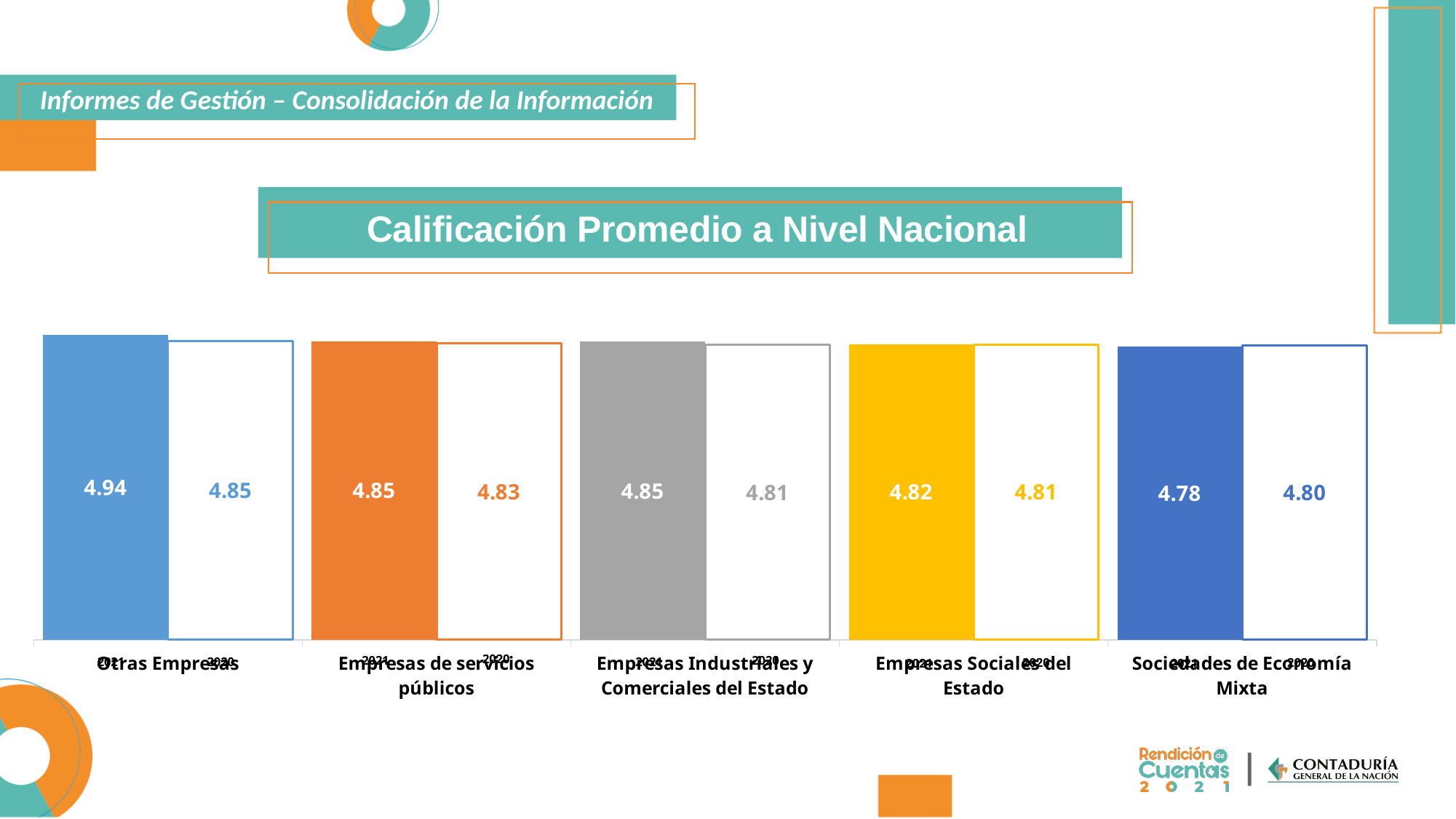
Which category has the highest value among the solid-filled bars? Otras Empresas What is the value shown on the solid-filled bar for Otras Empresas? 4.94 What kind of chart is shown on the slide? bar chart How many categories are shown on the x axis of the chart? 5 What is the title of the chart on the slide? Calificación Promedio a Nivel Nacional What is the difference between the solid-filled bar and the outlined bar for Otras Empresas? 0.09 For Sociedades de Economía Mixta, which is larger: the solid-filled bar value or the outlined bar value? the outlined bar (4.80) What is the value shown on the outlined (white) bar for Otras Empresas? 4.85 What is the value shown on the solid-filled bar for Sociedades de Economía Mixta? 4.78 What is the value shown on the outlined (white) bar for Empresas Industriales y Comerciales del Estado? 4.81 What is the value shown on the outlined (white) bar for Empresas de servicios públicos? 4.83 Which category has the lowest value among the solid-filled bars? Sociedades de Economía Mixta